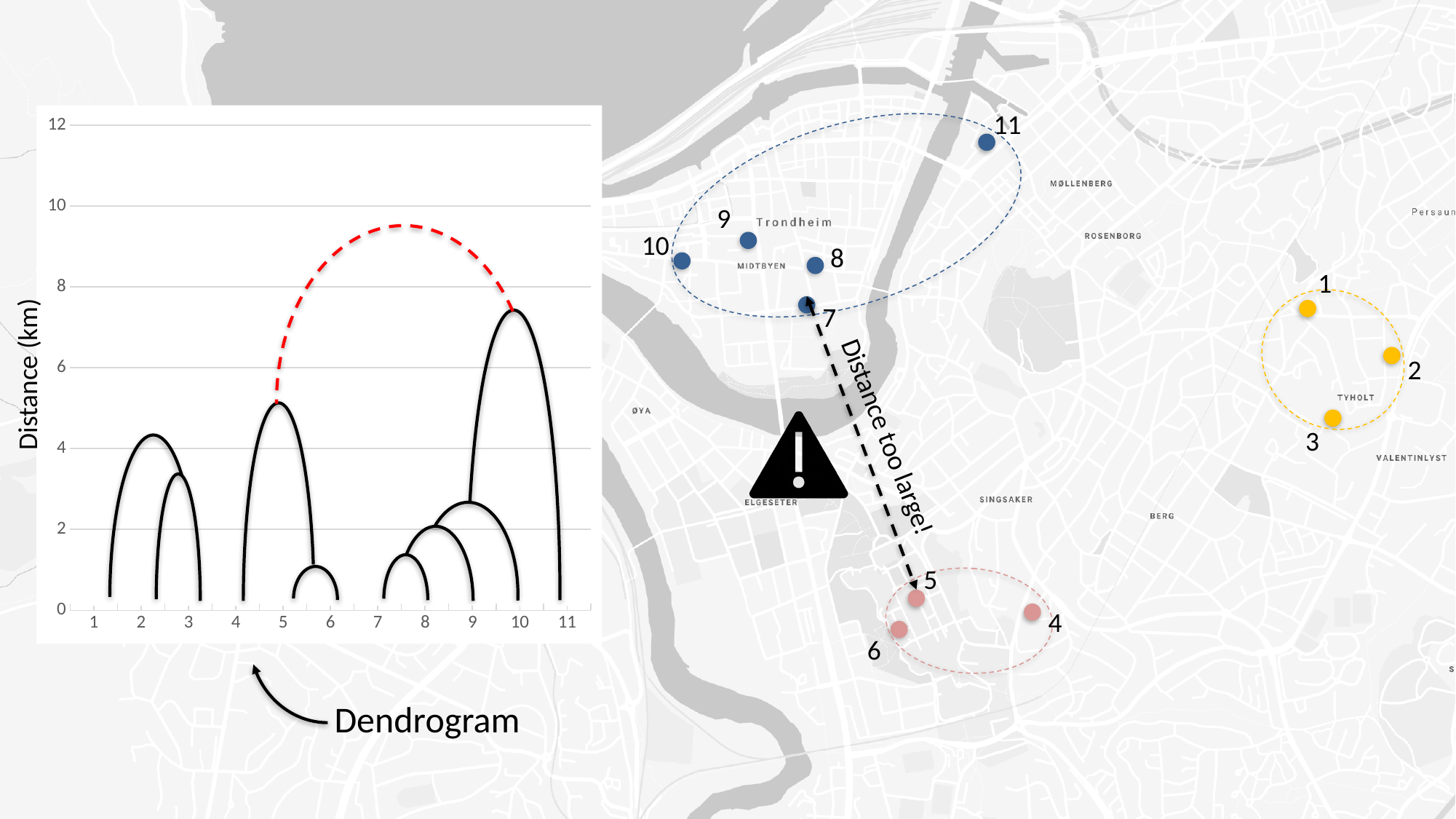
In the dendrogram, is the height at which point 11 joins the cluster of points 7 to 10 greater or less than 6? greater In the dendrogram, is the height of the red dashed arc greater or less than 8? greater What kind of chart is shown on the left of the slide? Dendrogram How many leaf points are labelled along the x axis of the dendrogram? 11 What is the y-axis title of the dendrogram? Distance (km) In the dendrogram, which merge is higher: point 1 joining points 2 and 3, or point 4 joining points 5 and 6? Point 4 joining points 5 and 6 In the dendrogram, which of the solid black arcs reaches the greatest height? The arc joining point 11 to the cluster of points 7 to 10 What is the highest tick value shown on the y axis of the dendrogram? 12 In the dendrogram, is the height at which points 7 and 8 merge greater or less than 4? less